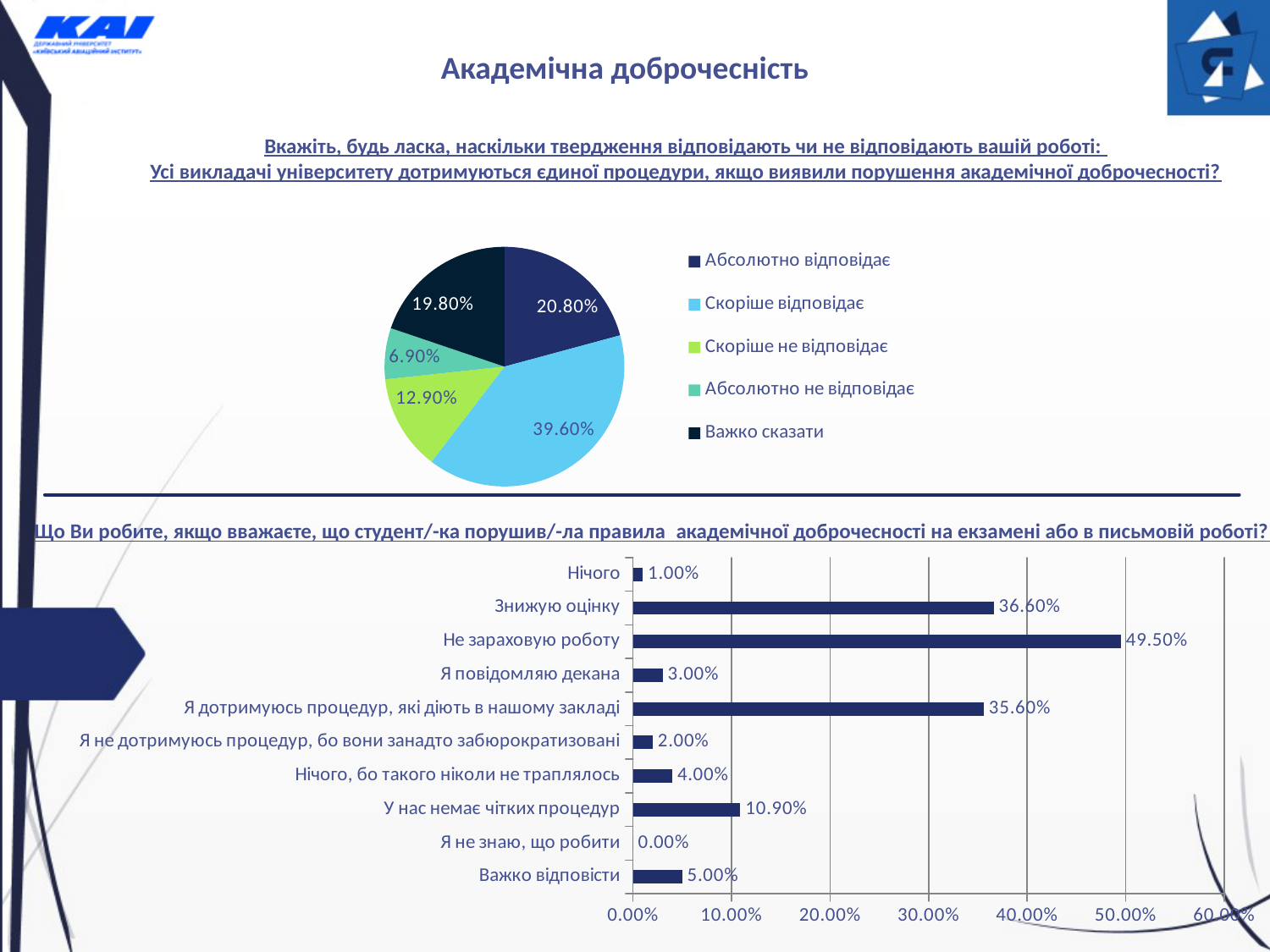
In the bar chart at the bottom of the slide, what is the value for "Не зараховую роботу"? 49.50% In the bar chart at the bottom of the slide, which category has the lowest value? Я не знаю, що робити How many entries does the legend of the pie chart at the top of the slide list? 5 In the pie chart at the top of the slide, what share is labelled for "Скоріше відповідає"? 39.60% What kind of chart is the bottom chart on the slide? Bar chart In the bar chart at the bottom of the slide, which is larger: "Знижую оцінку" or "Я дотримуюсь процедур, які діють в нашому закладі"? Знижую оцінку In the bar chart at the bottom of the slide, which category has the highest value? Не зараховую роботу In the pie chart at the top of the slide, what is the difference between the shares for "Абсолютно відповідає" and "Важко сказати"? 1.00% In the bar chart at the bottom of the slide, what is the difference between "Не зараховую роботу" and "Знижую оцінку"? 12.90% What kind of chart is the top chart on the slide? Pie chart In the pie chart at the top of the slide, which category has the smallest slice? Абсолютно не відповідає How many categories are shown in the bar chart at the bottom of the slide? 10